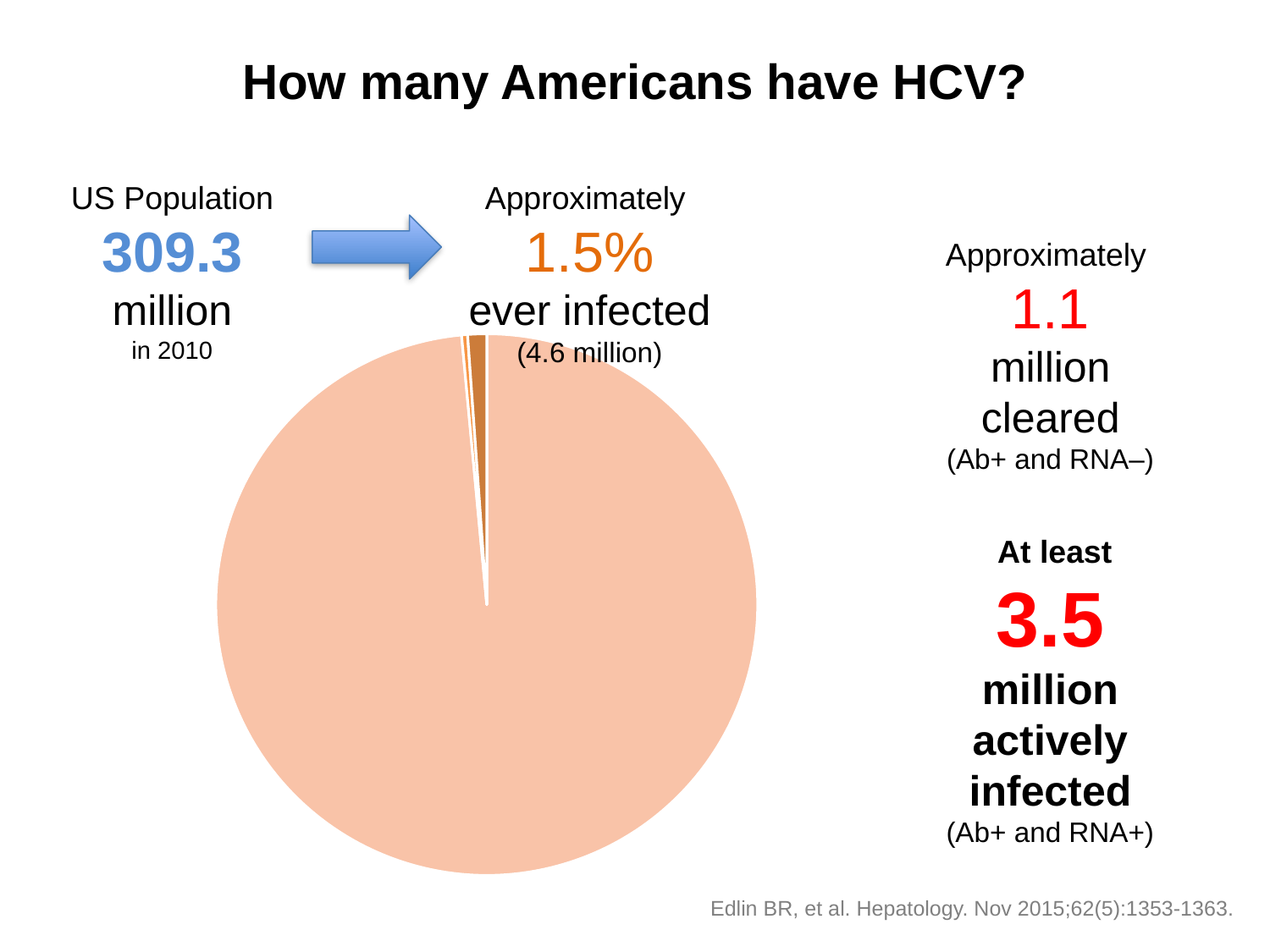
Approximately what percentage of the US population has ever been infected with HCV? 1.5% What is the difference between the number actively infected and the number who cleared HCV? 2.4 million What kind of chart is shown on the slide? pie chart How many slices does the pie chart have? 3 What is the combined total of those who cleared HCV and those actively infected? 4.6 million What is the title of the slide containing the pie chart? How many Americans have HCV? Which group is larger: those who cleared HCV or those actively infected? actively infected At least how many Americans are actively infected with HCV (Ab+ and RNA+)? 3.5 million What was the US population in 2010 according to the slide? 309.3 million How many Americans have ever been infected with HCV, in millions? 4.6 million Approximately how many Americans have cleared HCV (Ab+ and RNA–)? 1.1 million